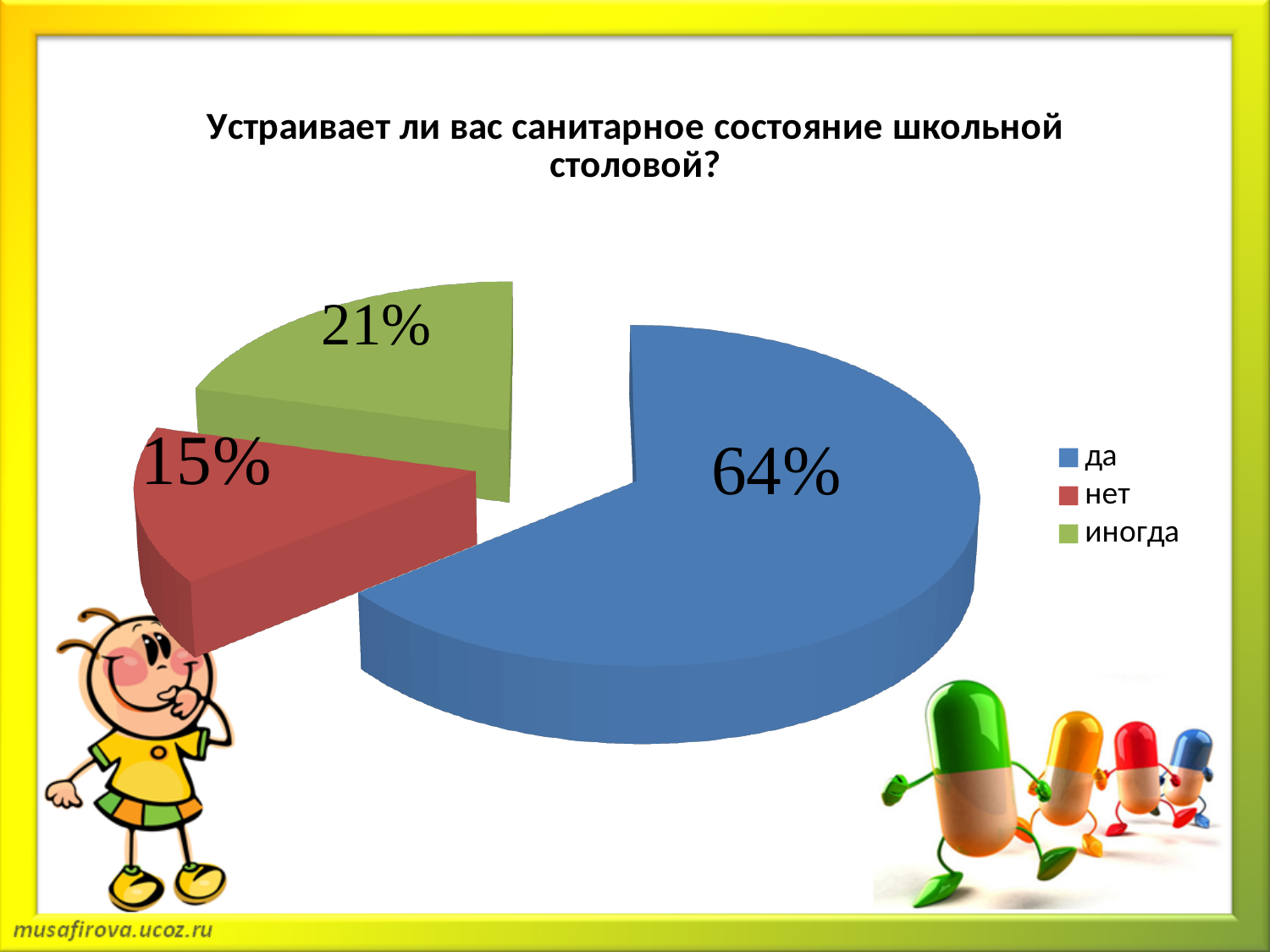
What is the difference in percentage points between "иногда" and "нет"? 6 How many slices does the pie chart have? 3 What is the difference in percentage points between "да" and "иногда"? 43 Which answer has the largest share of the pie? да Which answer has the smallest share of the pie? нет What percentage of respondents answered "иногда"? 21% Which is larger, the share for "нет" or the share for "иногда"? иногда What type of chart is shown on the slide? pie chart What percentage of respondents answered "да"? 64% What percentage of respondents answered "нет"? 15% What colour is the slice for "иногда"? green How many entries does the legend list? 3